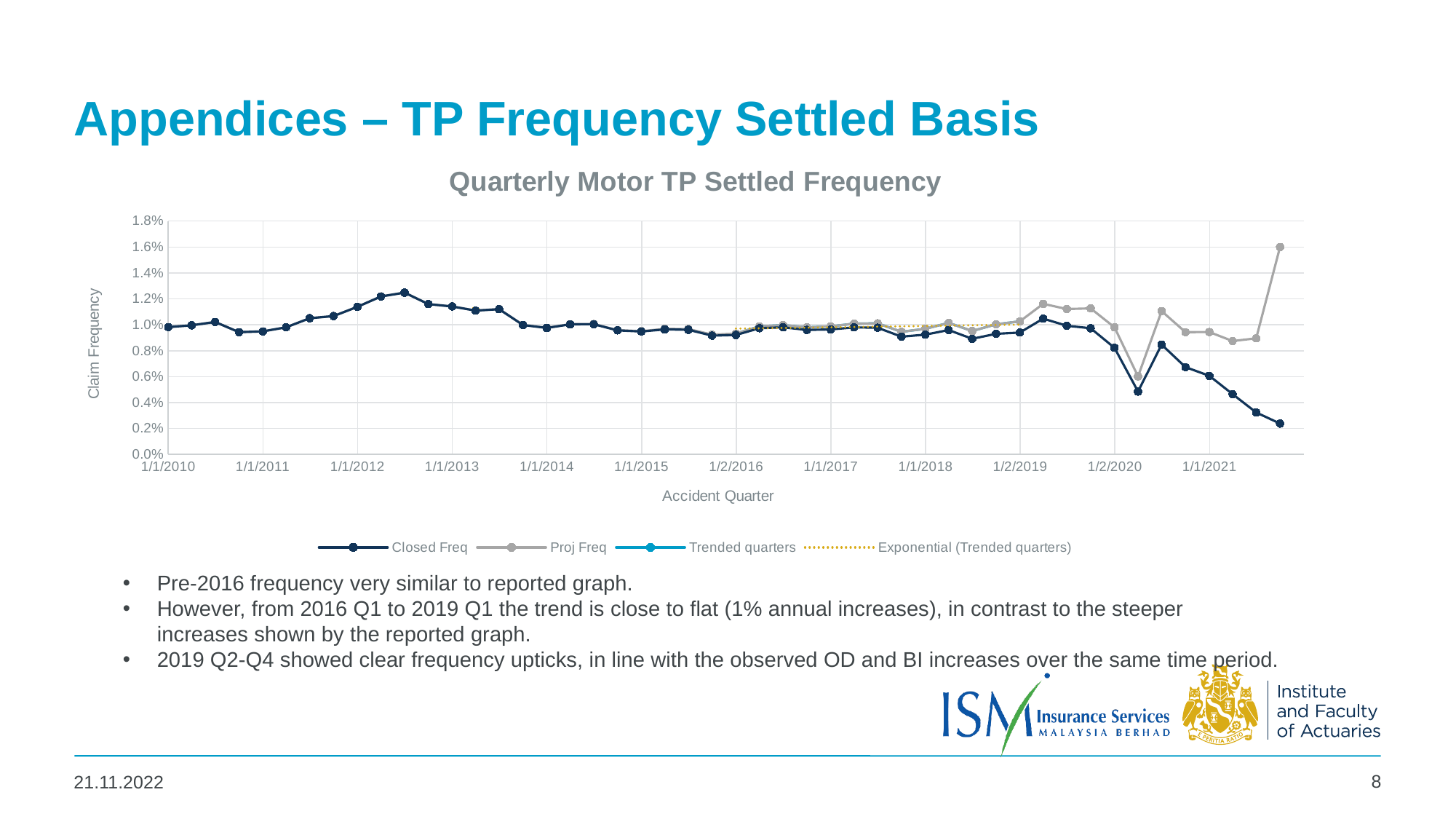
What kind of chart is shown on the slide? Line chart How many series does the legend list? 4 Is the Proj Freq value at the last plotted quarter greater or less than 1.4%? greater What is the title of the chart? Quarterly Motor TP Settled Frequency Is the Closed Freq value at the last plotted quarter greater or less than 0.4%? less At the last plotted quarter, which series is higher: Closed Freq or Proj Freq? Proj Freq What is the label of the vertical axis? Claim Frequency Is the Closed Freq value at 1/1/2021 greater or less than 0.8%? less Does the Closed Freq series rise or fall from 1/1/2021 to the end of the chart? Fall How many year labels are shown on the x axis? 12